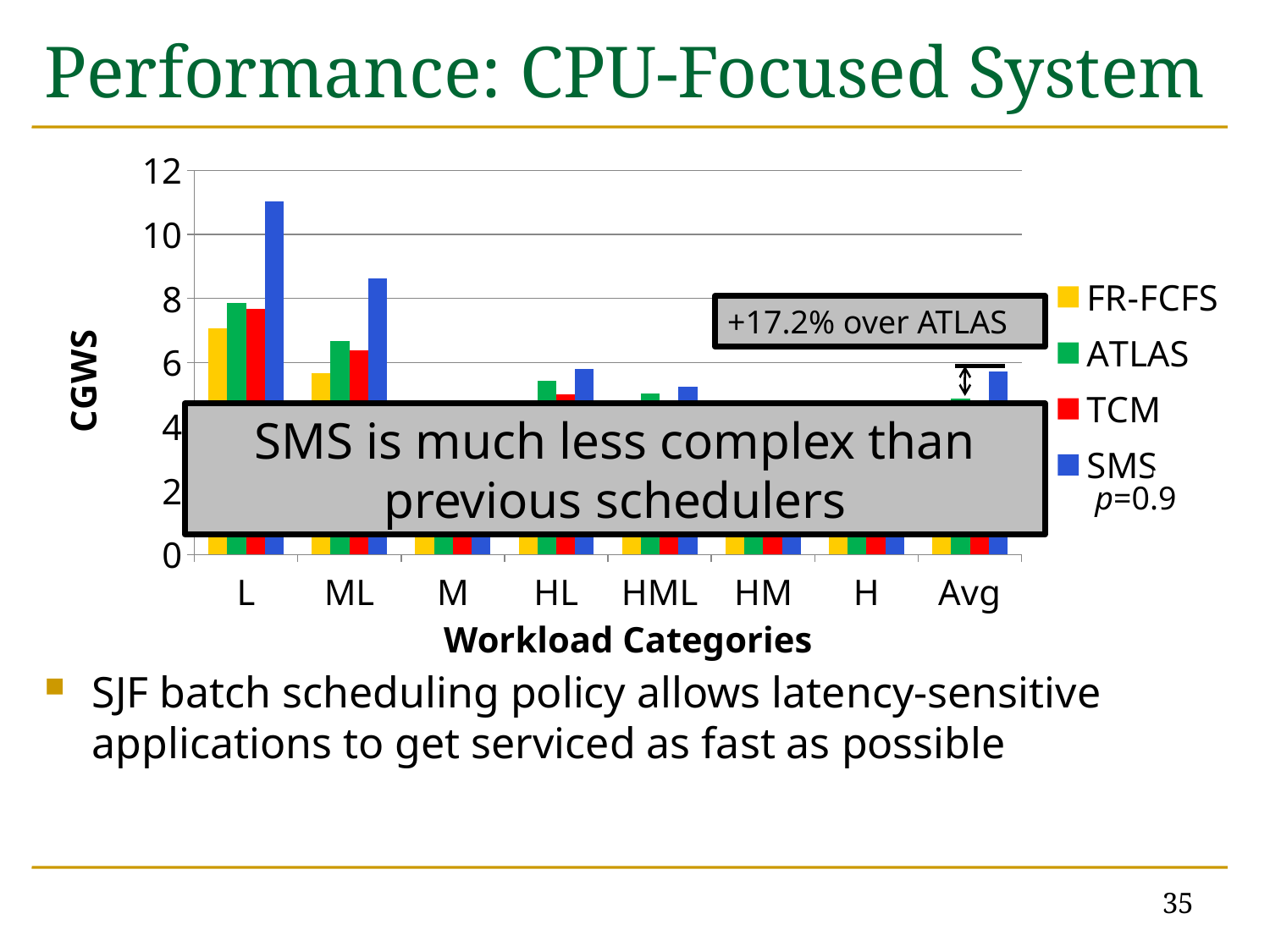
Is the SMS value for the ML category greater or less than 8? greater What is the label of the y axis? CGWS What improvement over ATLAS does the annotation on the chart state? +17.2% over ATLAS How many series does the legend list? 4 In which workload category does SMS reach its highest value? L How many workload categories are shown on the x axis? 8 Is the TCM value for the L category greater or less than 6? greater Is the SMS value for the L category greater or less than 10? greater For the L category, which is larger: the SMS value or the FR-FCFS value? SMS What kind of chart is shown on the slide? bar chart Which series has the highest value for the L workload category? SMS